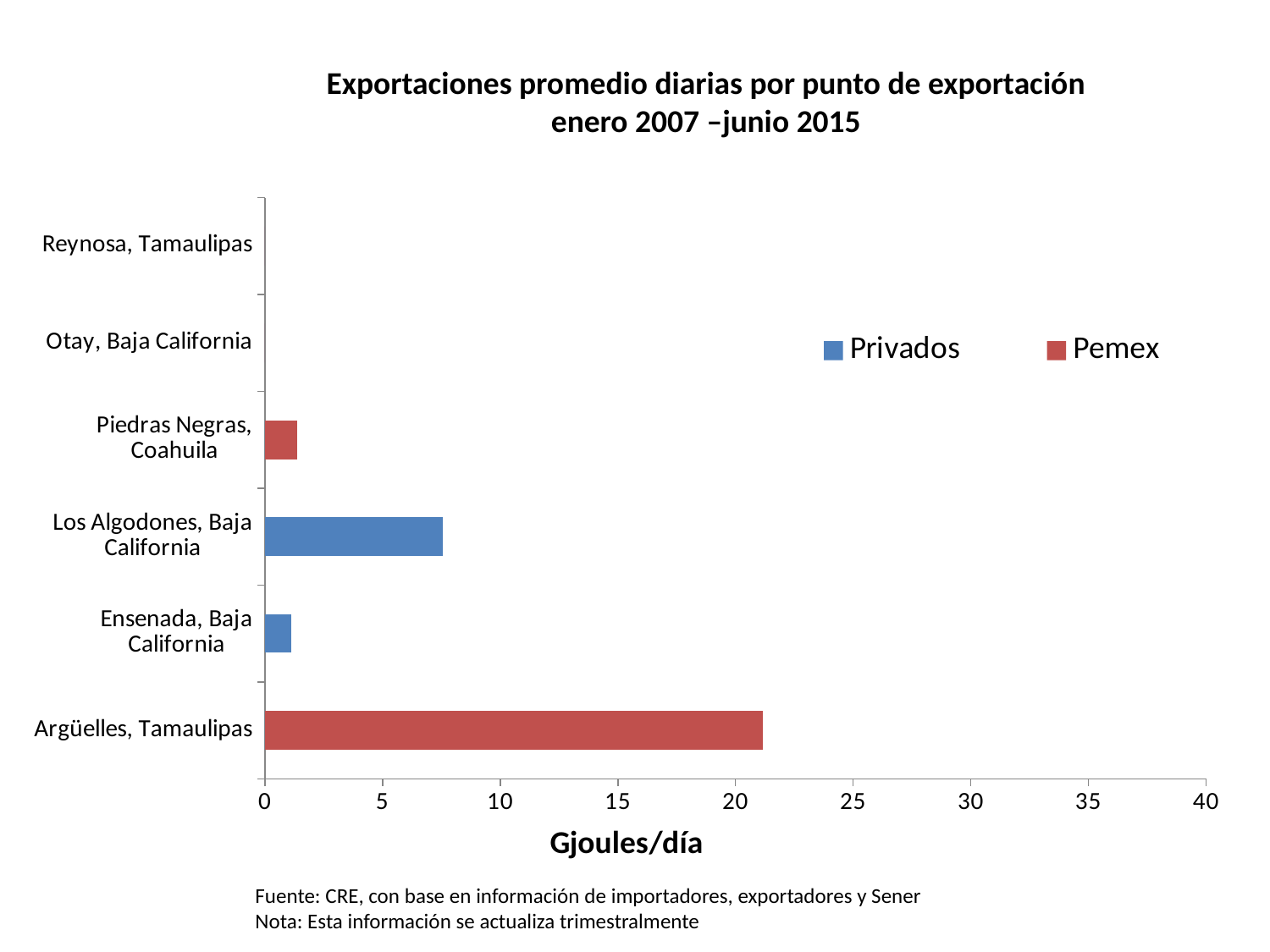
Is the value for Los Algodones, Baja California greater or less than 10? less What kind of chart is shown on the slide? Bar chart How many series does the legend list? 2 Which is larger, the value for Argüelles, Tamaulipas or the value for Los Algodones, Baja California? Argüelles, Tamaulipas Is the value for Los Algodones, Baja California greater or less than 5? greater Which is larger, the value for Los Algodones, Baja California or the value for Ensenada, Baja California? Los Algodones, Baja California Is the value for Argüelles, Tamaulipas greater or less than 15? greater Which export point has the highest average daily exports? Argüelles, Tamaulipas Which series does the red colour represent in the legend? Pemex How many export points (categories) are listed on the vertical axis? 6 What is the label of the horizontal axis? Gjoules/día